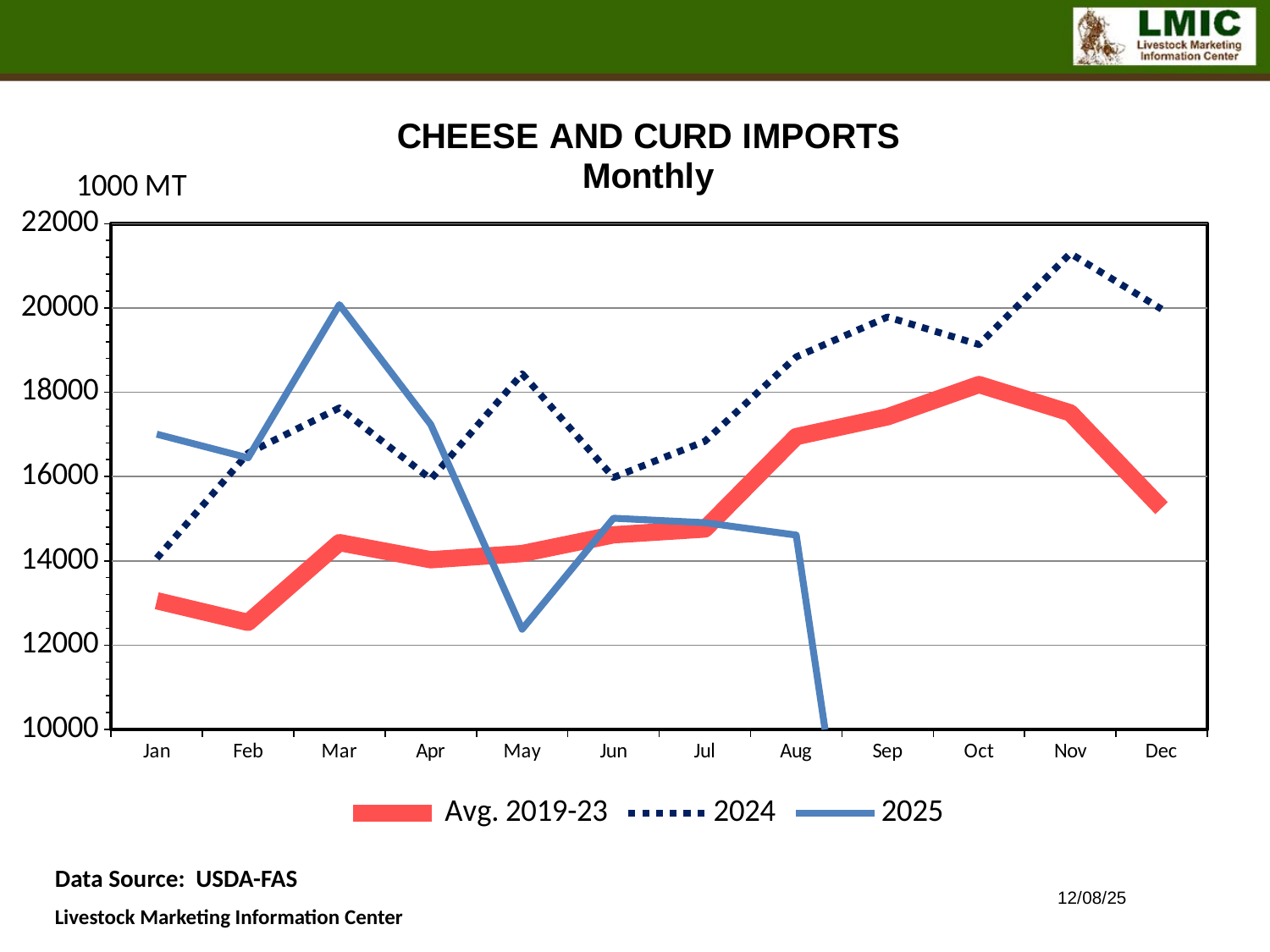
What kind of chart is shown on the slide? line chart In Mar, which series is higher: 2024 or 2025? 2025 Does the 2024 series rise or fall from Aug to Nov? rise Is the 2025 value for May greater or less than 14000? less In which month is the Avg. 2019-23 series at its lowest? Feb What unit is shown on the y axis? 1000 MT Is the 2024 value for Nov greater or less than 20000? greater In which month does the 2024 series reach its highest value? Nov How many series does the legend list? 3 How many months are shown along the x axis? 12 In which month is the 2024 series at its lowest? Jan In which month does the 2025 series reach its highest value? Mar